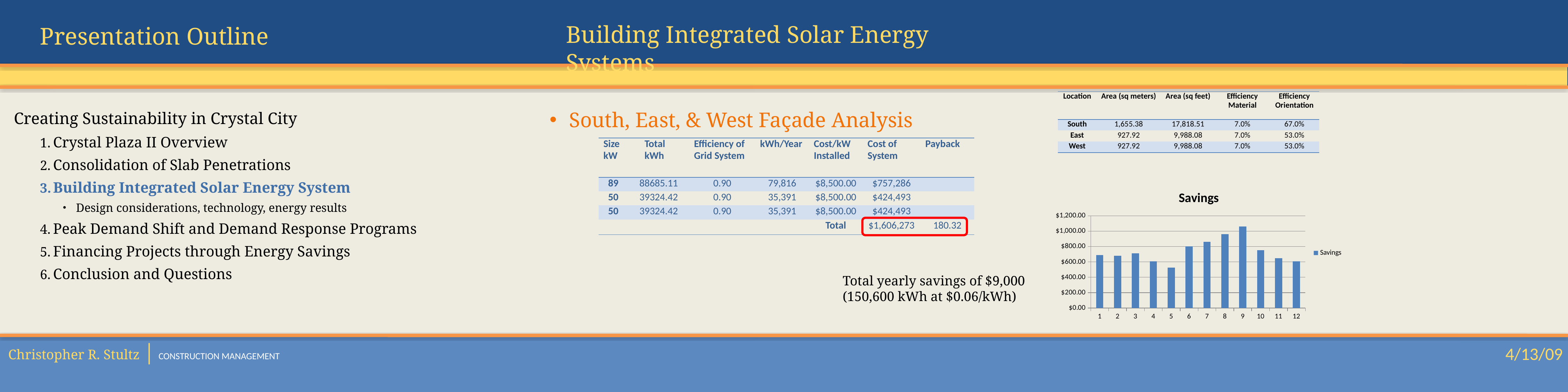
In the Savings chart, do the values rise or fall from category 5 to category 9? rise In the Savings chart, is the value for category 5 greater or less than $600.00? less How many series does the legend of the Savings chart list? 1 In the Savings chart, which category has the lowest value? 5 In the Savings chart, which is larger, the value for category 8 or the value for category 1? 8 In the Savings chart, is the value for category 8 greater or less than $800.00? greater In the Savings chart, which category has the highest value? 9 What is the legend entry of the Savings chart? Savings What kind of chart is the Savings chart? bar chart In the Savings chart, is the value for category 9 greater or less than $800.00? greater How many categories are shown on the x axis of the Savings chart? 12 What is the title of the bar chart on the slide? Savings